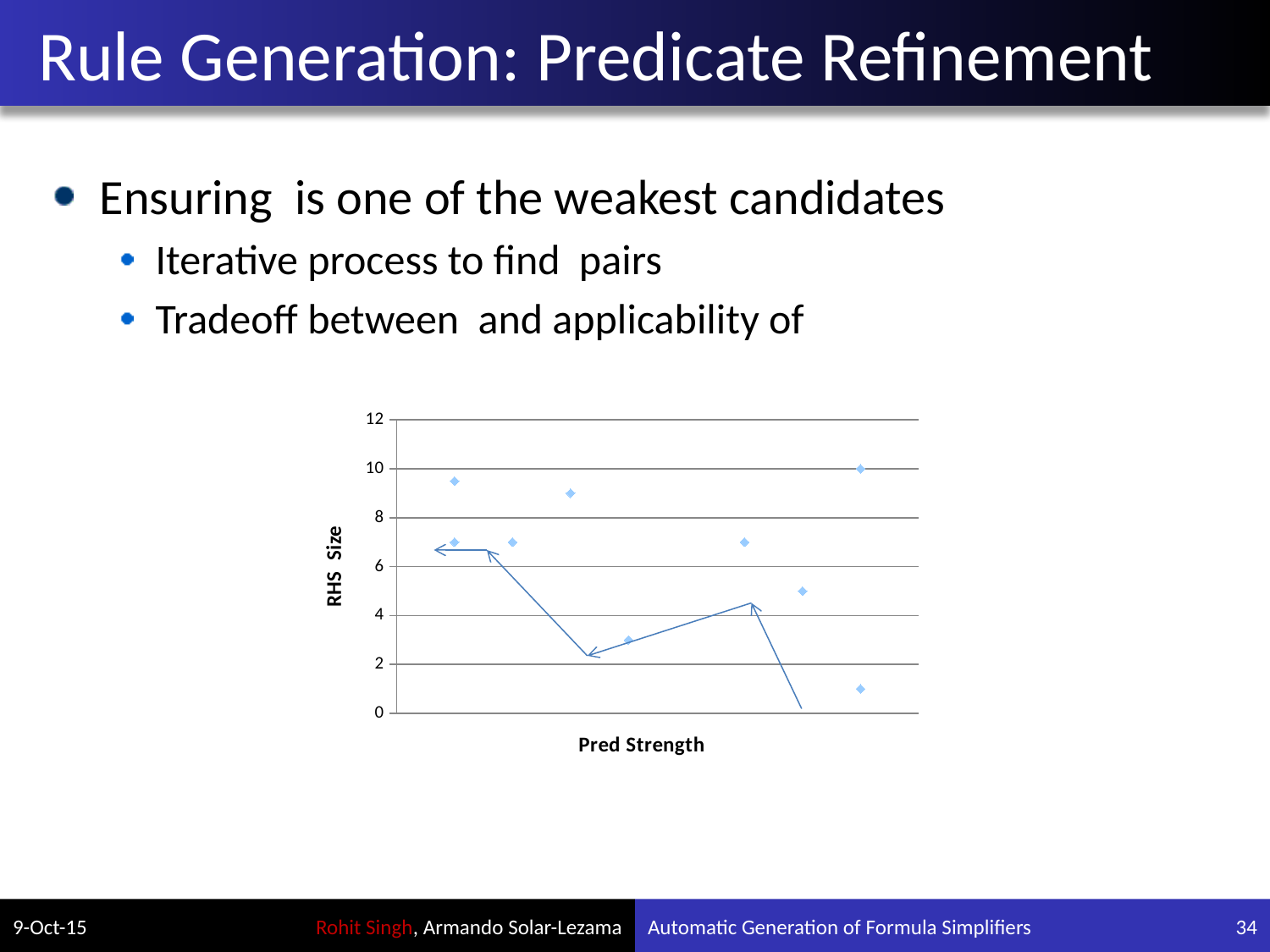
What is the title of the y axis of the chart? RHS Size What kind of chart is shown on the slide? scatter plot What is the maximum value shown on the y axis of the chart? 12 Is the RHS Size of the highest plotted point greater or less than 8? greater What is the title of the x axis of the chart? Pred Strength Is the RHS Size of the lowest plotted point greater or less than 2? less How many data points are plotted on the chart? 9 Does the chart include a legend? No